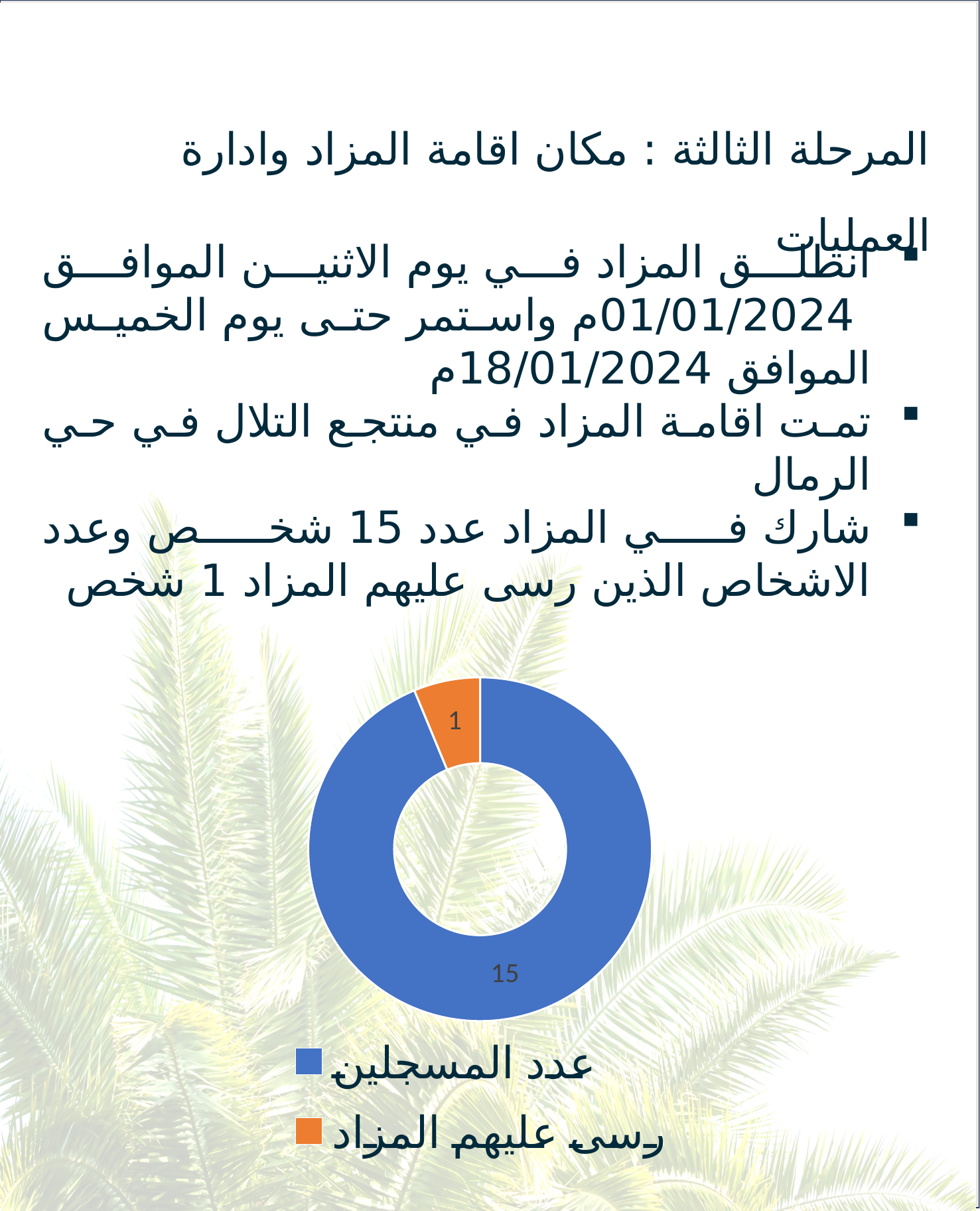
Which category has the smallest slice in the chart? رسى عليهم المزاد What is the total of the two values shown in the chart? 16 What colour is the slice for عدد المسجلين? blue What kind of chart is shown on the slide? doughnut chart What is the difference between the value for عدد المسجلين and the value for رسى عليهم المزاد? 14 What is the value for رسى عليهم المزاد in the doughnut chart? 1 How many entries does the chart legend list? 2 How many slices does the chart have? 2 Which category has the largest slice in the chart? عدد المسجلين Which is larger, the value for عدد المسجلين or the value for رسى عليهم المزاد? عدد المسجلين What colour is the slice for رسى عليهم المزاد? orange What is the value for عدد المسجلين in the doughnut chart? 15